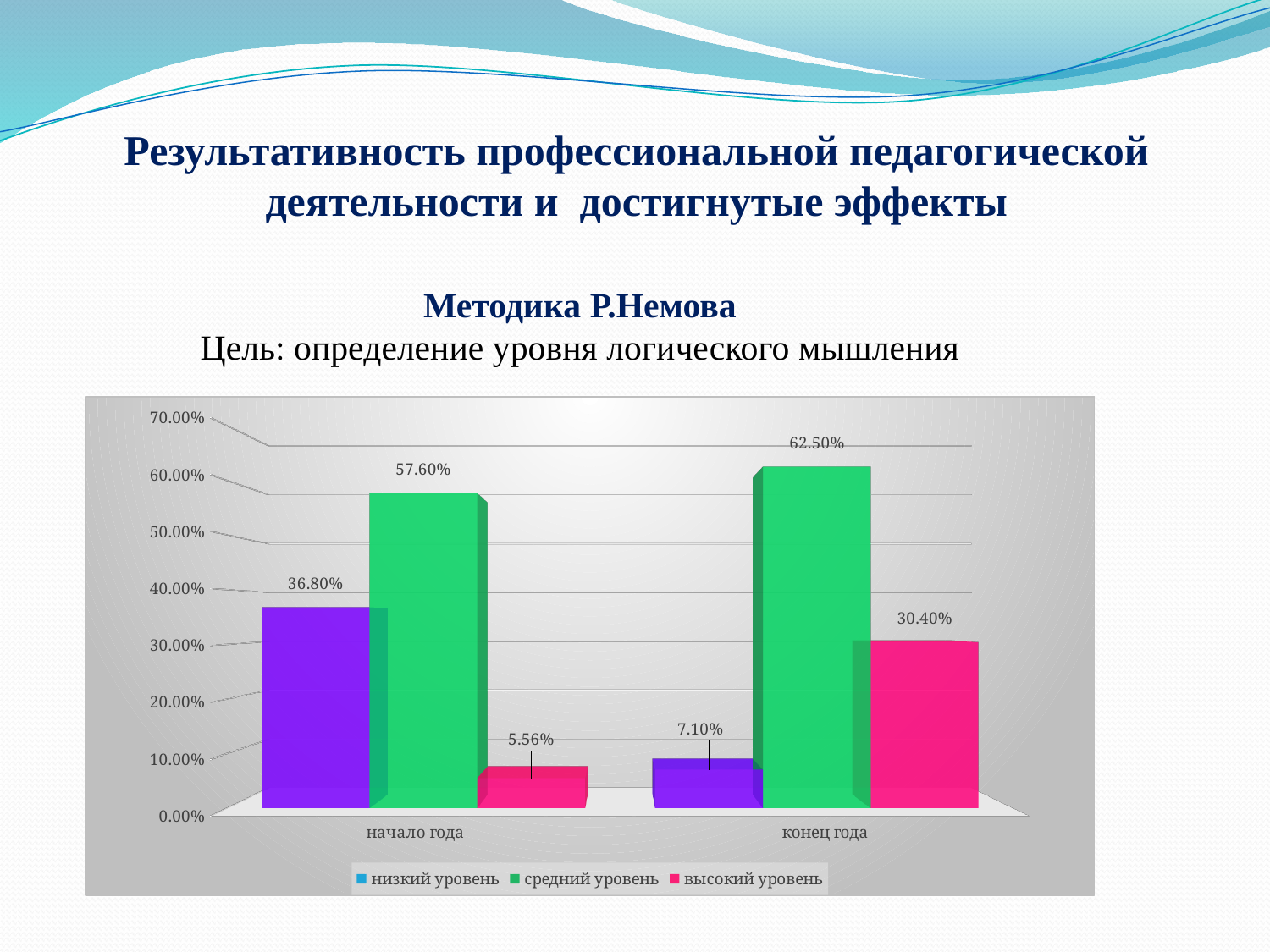
Which is larger: низкий уровень at начало года or низкий уровень at конец года? начало года What is the difference between the средний уровень values at конец года and начало года? 4.90% What is the value for низкий уровень at конец года? 7.10% What kind of chart is shown on the slide? bar chart Does the value for высокий уровень rise or fall from начало года to конец года? rise Which series has the highest value at конец года? средний уровень What is the value for высокий уровень at начало года? 5.56% How many series does the legend list? 3 How many categories are shown on the x axis? 2 What is the value for высокий уровень at конец года? 30.40% What is the value for средний уровень at начало года? 57.60% Which series has the lowest value at начало года? высокий уровень